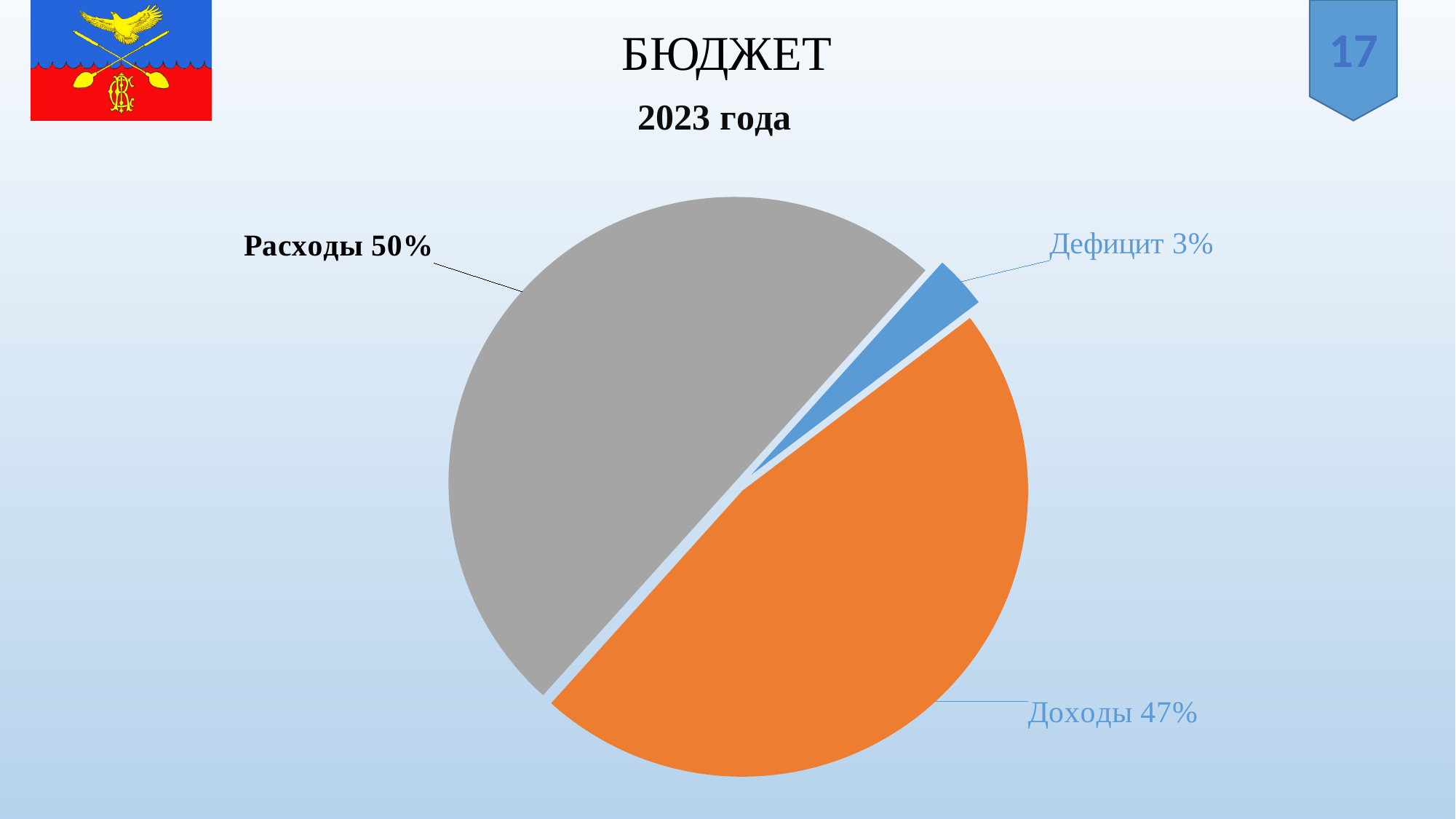
How many slices does the pie chart have? 3 Which slice of the pie is the smallest? Дефицит Which slice of the pie is the largest? Расходы What is the difference in percentage points between Расходы and Доходы? 3 What year does the chart's subtitle refer to? 2023 Which is larger, Расходы or Доходы? Расходы What is the difference in percentage points between Доходы and Дефицит? 44 What share of the pie does Доходы take? 47% What share of the pie does Расходы take? 50% What share of the pie does Дефицит take? 3% What kind of chart is shown on the slide? pie chart What colour is the Доходы slice? orange